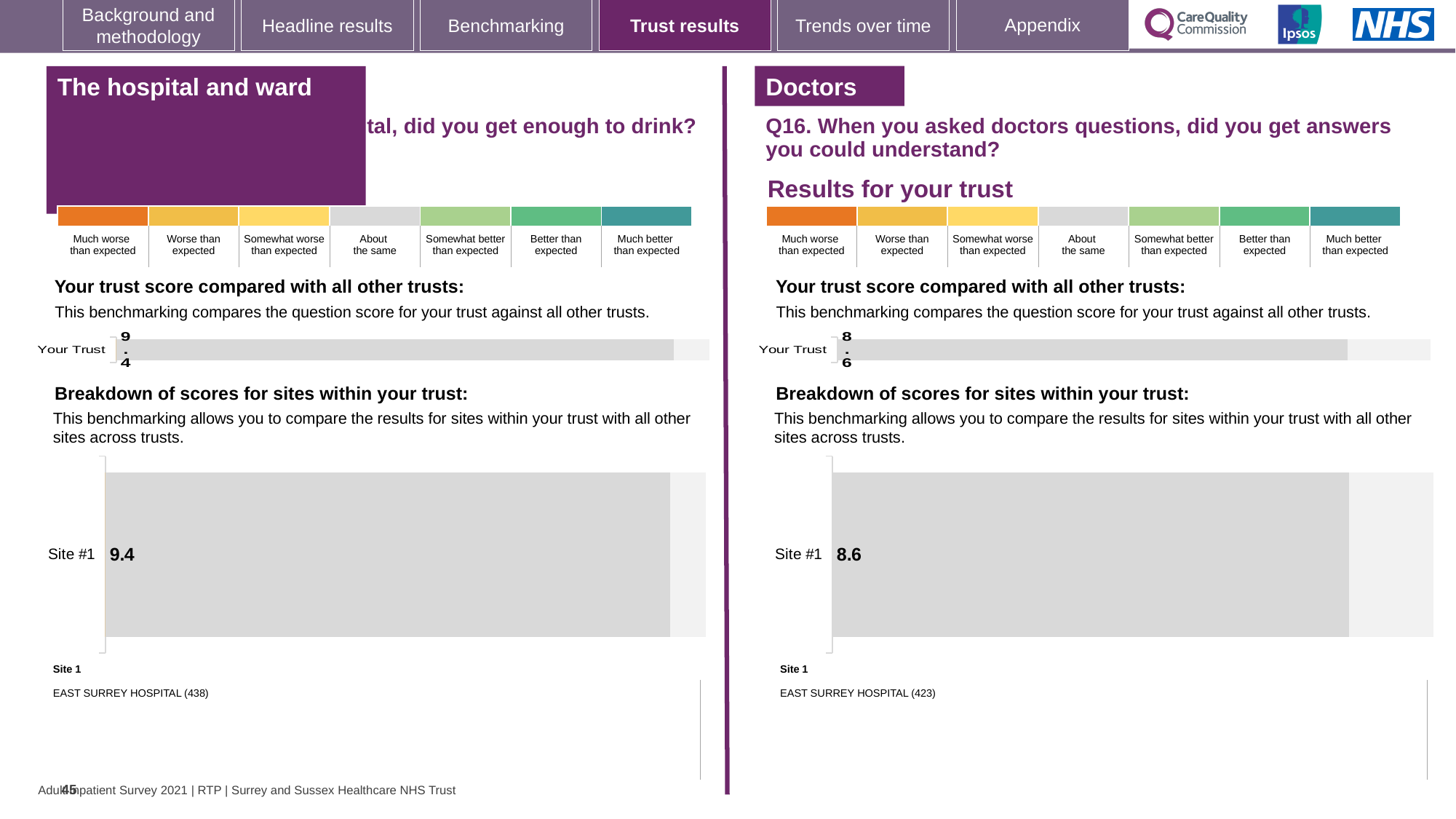
On the right panel (Doctors, Q16), what is the score shown for Your Trust in the 'Your trust score compared with all other trusts' chart? 8.6 Which is larger: the Your Trust score on the left panel (The hospital and ward) or the Your Trust score on the right panel (Doctors, Q16)? The hospital and ward (9.4) How many sites are shown in the 'Breakdown of scores for sites within your trust' chart on the left panel (The hospital and ward)? 1 What type of chart is used to show the Site #1 score on the right panel (Doctors, Q16)? Bar chart On the left panel (The hospital and ward), what is the score shown for Your Trust in the 'Your trust score compared with all other trusts' chart? 9.4 How many sites are shown in the 'Breakdown of scores for sites within your trust' chart on the right panel (Doctors, Q16)? 1 In the 'Breakdown of scores for sites within your trust' chart on the right panel (Doctors, Q16), what is the score for Site #1? 8.6 How many rating categories does the colour key on the right panel (Doctors, Q16) list? 7 What is the difference between the Site #1 score on the left panel (The hospital and ward) and the Site #1 score on the right panel (Doctors, Q16)? 0.8 Which site is listed as Site 1 beneath the breakdown chart on the right panel (Doctors, Q16)? EAST SURREY HOSPITAL (423) Which site is listed as Site 1 beneath the breakdown chart on the left panel (The hospital and ward)? EAST SURREY HOSPITAL (438) In the 'Breakdown of scores for sites within your trust' chart on the left panel (The hospital and ward), what is the score for Site #1? 9.4